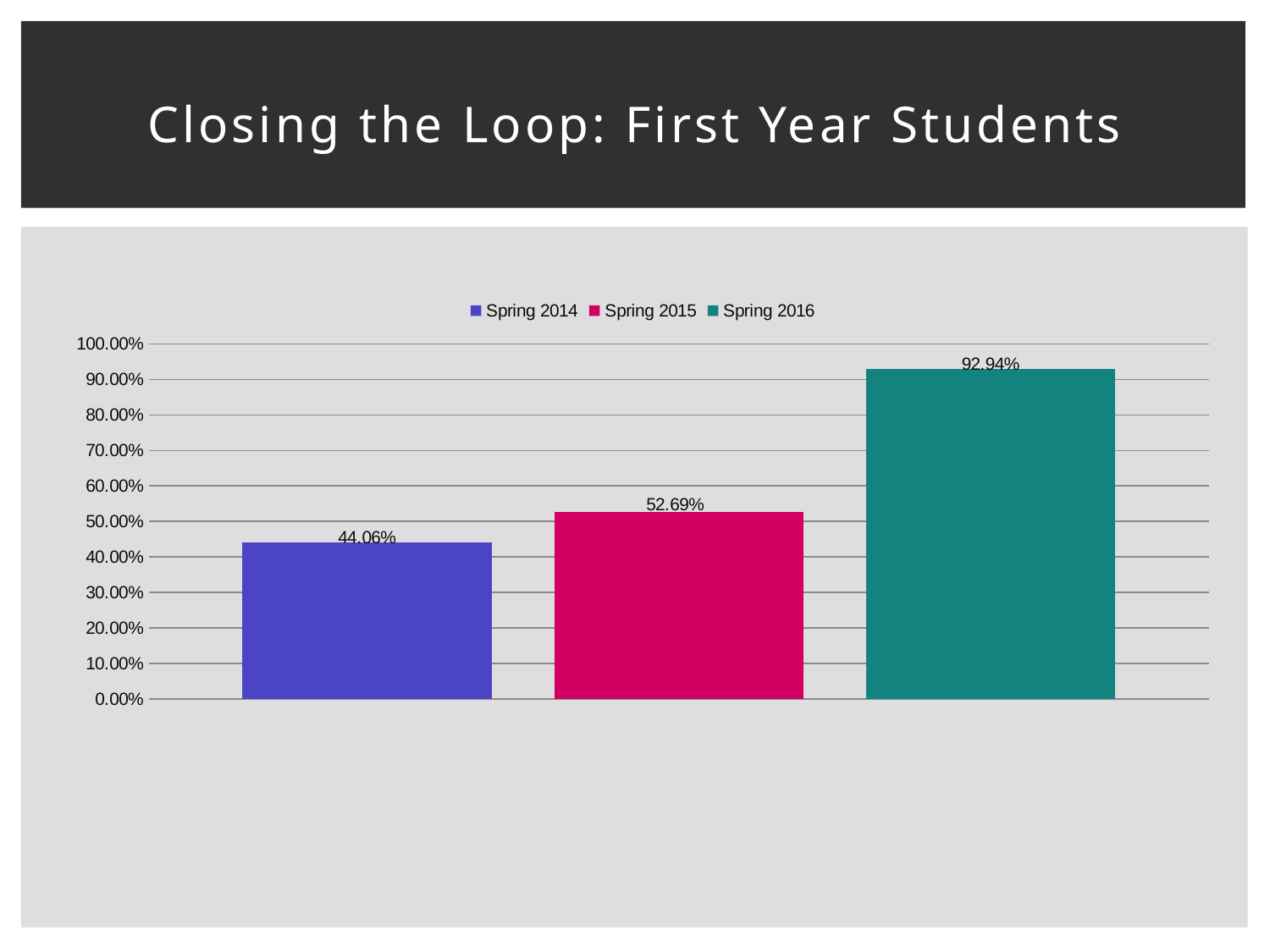
What is the value for Spring 2015? 52.69% Which series has the lowest value? Spring 2014 Do the values rise or fall from Spring 2014 to Spring 2016? Rise Which series has the highest value? Spring 2016 Is the value for Spring 2016 greater or less than 90.00%? greater What is the difference between the Spring 2015 and Spring 2014 values? 8.63% How many series does the legend list? 3 What is the difference between the Spring 2016 and Spring 2015 values? 40.25% What kind of chart is shown on the slide? Bar chart What is the value for Spring 2014? 44.06% What is the value for Spring 2016? 92.94% Which is larger, the value for Spring 2014 or Spring 2015? Spring 2015